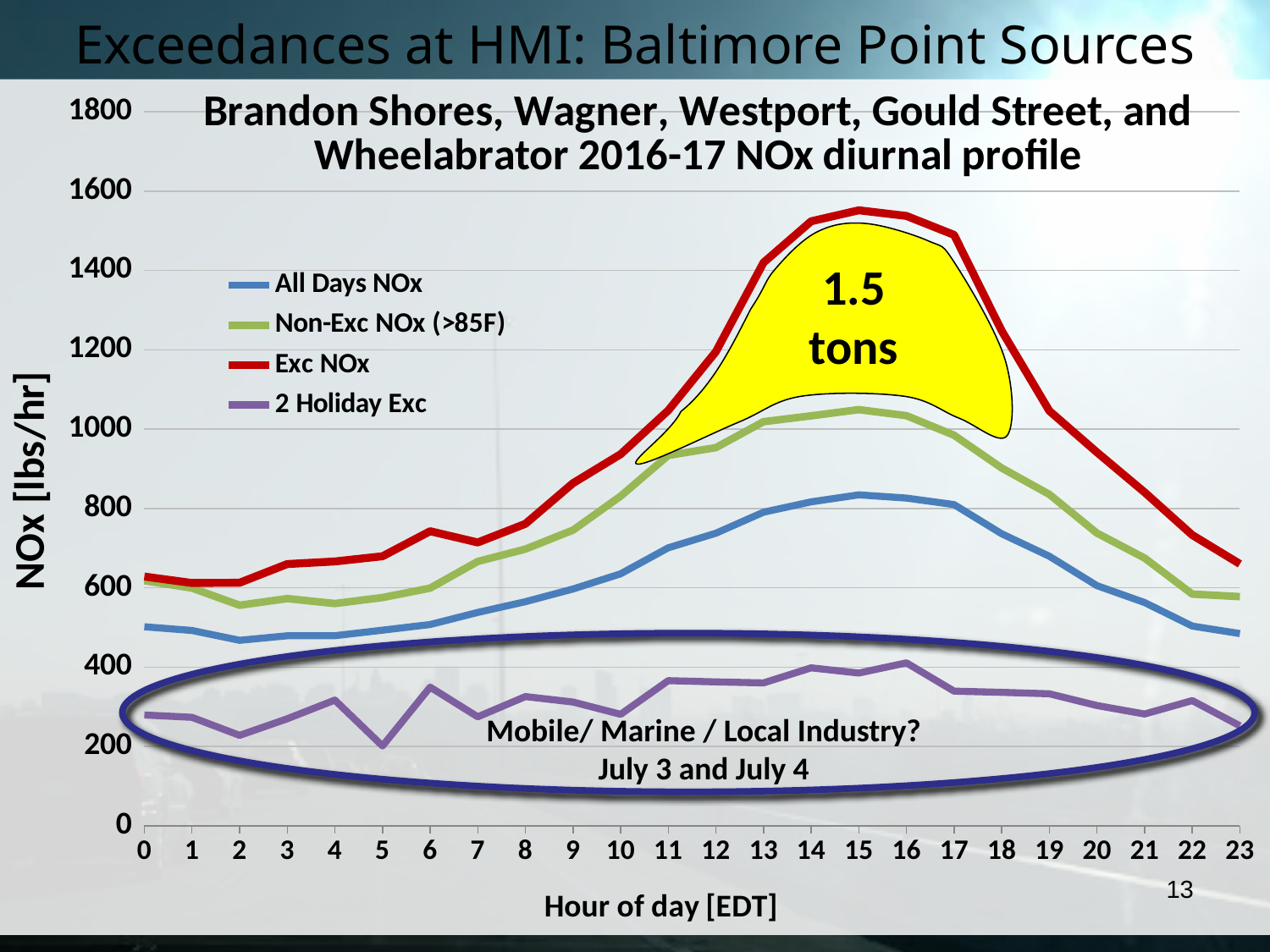
Is the Exc NOx value at hour 15 greater or less than 1400? greater How many hours of the day are plotted along the x axis? 24 Is the All Days NOx value at hour 0 greater or less than 600? less At hour 15, which is larger: Exc NOx or All Days NOx? Exc NOx How many series does the legend list? 4 What kind of chart is shown on the slide? Line chart Which series has the lowest values across the day? 2 Holiday Exc At which hour of day does the Exc NOx series reach its peak? 15 Which series reaches the highest value on the chart? Exc NOx Is the 2 Holiday Exc value at hour 5 greater or less than 400? less Does the Exc NOx series rise or fall from hour 15 to hour 23? Fall What is the label on the y axis of the chart? NOx [lbs/hr]